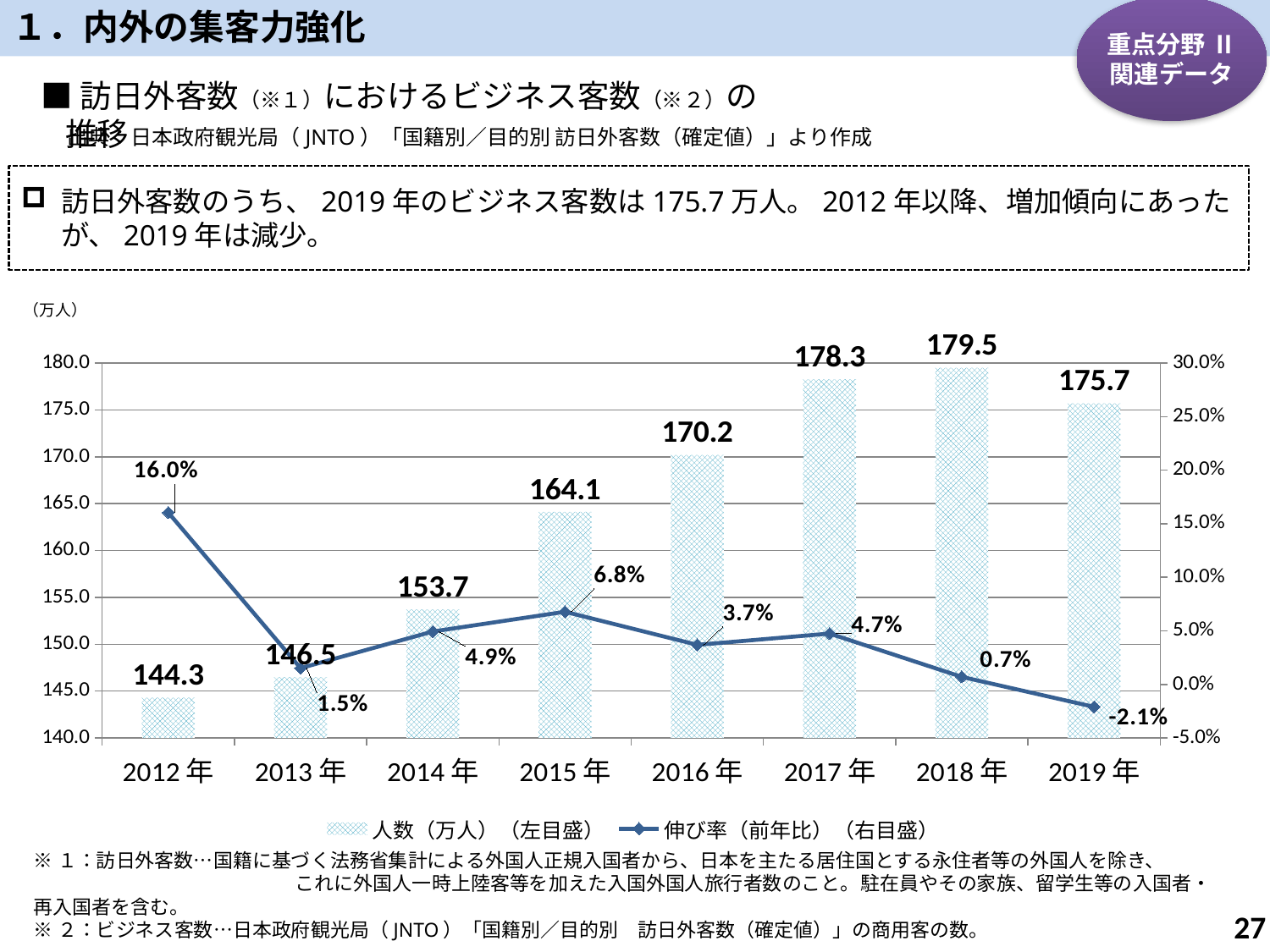
What is the value of 人数（万人） for 2018年? 179.5 Does the 人数（万人） rise or fall from 2012年 to 2018年? Rise What is the 伸び率（前年比） for 2015年? 6.8% How many years are shown on the x axis? 8 How many series does the legend list? 2 Which year has the highest 人数（万人）? 2018年 What is the difference in 人数（万人） between 2019年 and 2018年? 3.8 Which is larger, the 人数（万人） for 2016年 or for 2017年? 2017年 Which year has the lowest 伸び率（前年比）? 2019年 What is the 伸び率（前年比） for 2019年? -2.1% What kind of chart is this? Combined bar and line chart What is the value of 人数（万人） for 2012年? 144.3